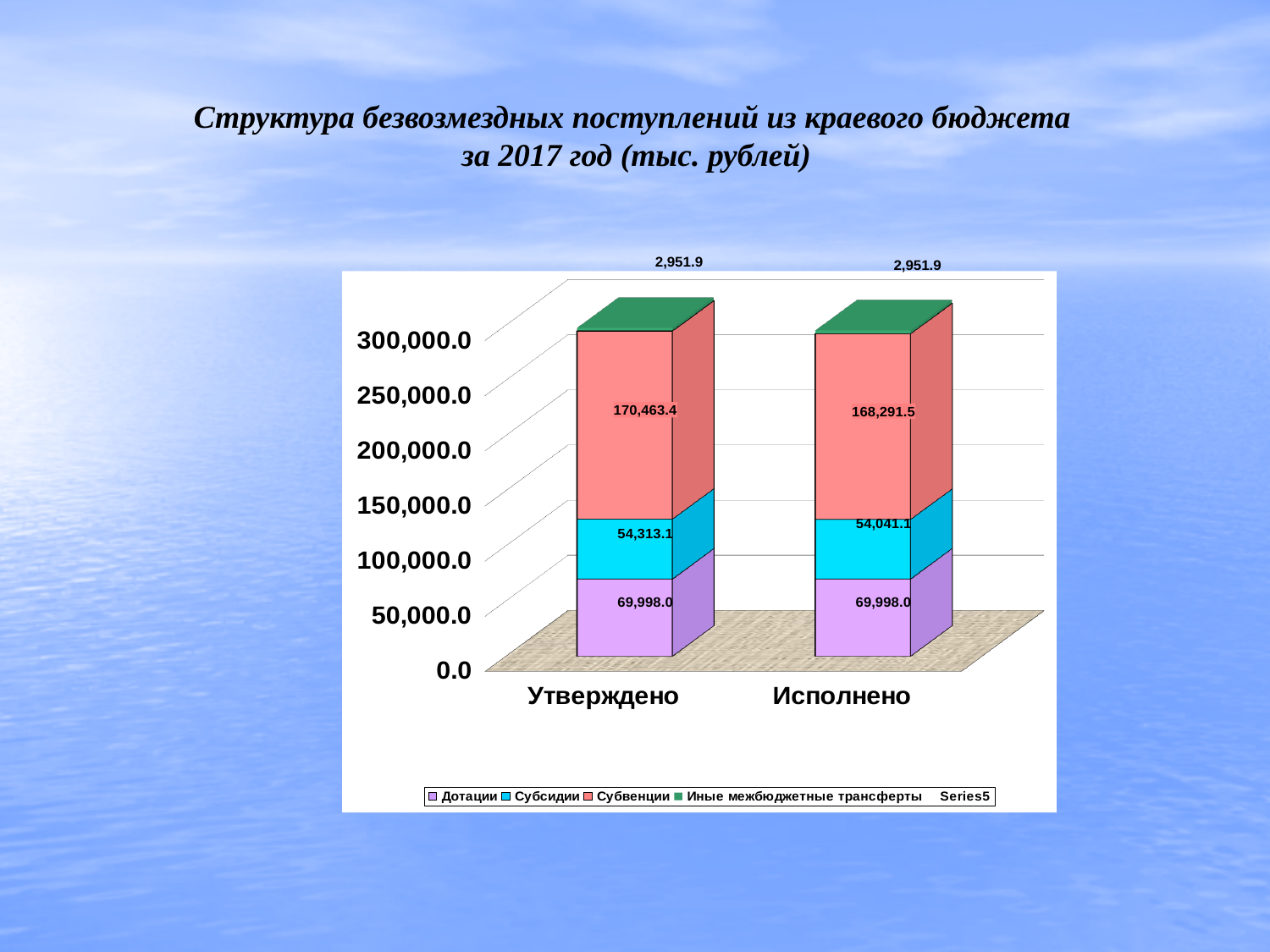
What is the difference between the Субвенции values for Утверждено and Исполнено? 2,171.9 What is the value of Субвенции for Исполнено? 168,291.5 What kind of chart is shown on the slide? Stacked bar chart How many categories are shown on the x axis? 2 What is the difference between the Субсидии values for Утверждено and Исполнено? 272.0 What is the total of the stacked bar for Утверждено? 297,726.4 Which is larger, the Субвенции value for Утверждено or for Исполнено? Утверждено What is the total of the stacked bar for Исполнено? 295,282.5 What is the value of Субсидии for Исполнено? 54,041.1 What is the value of Дотации for Утверждено? 69,998.0 What is the value of Субвенции for Утверждено? 170,463.4 What is the value of Иные межбюджетные трансферты for Исполнено? 2,951.9